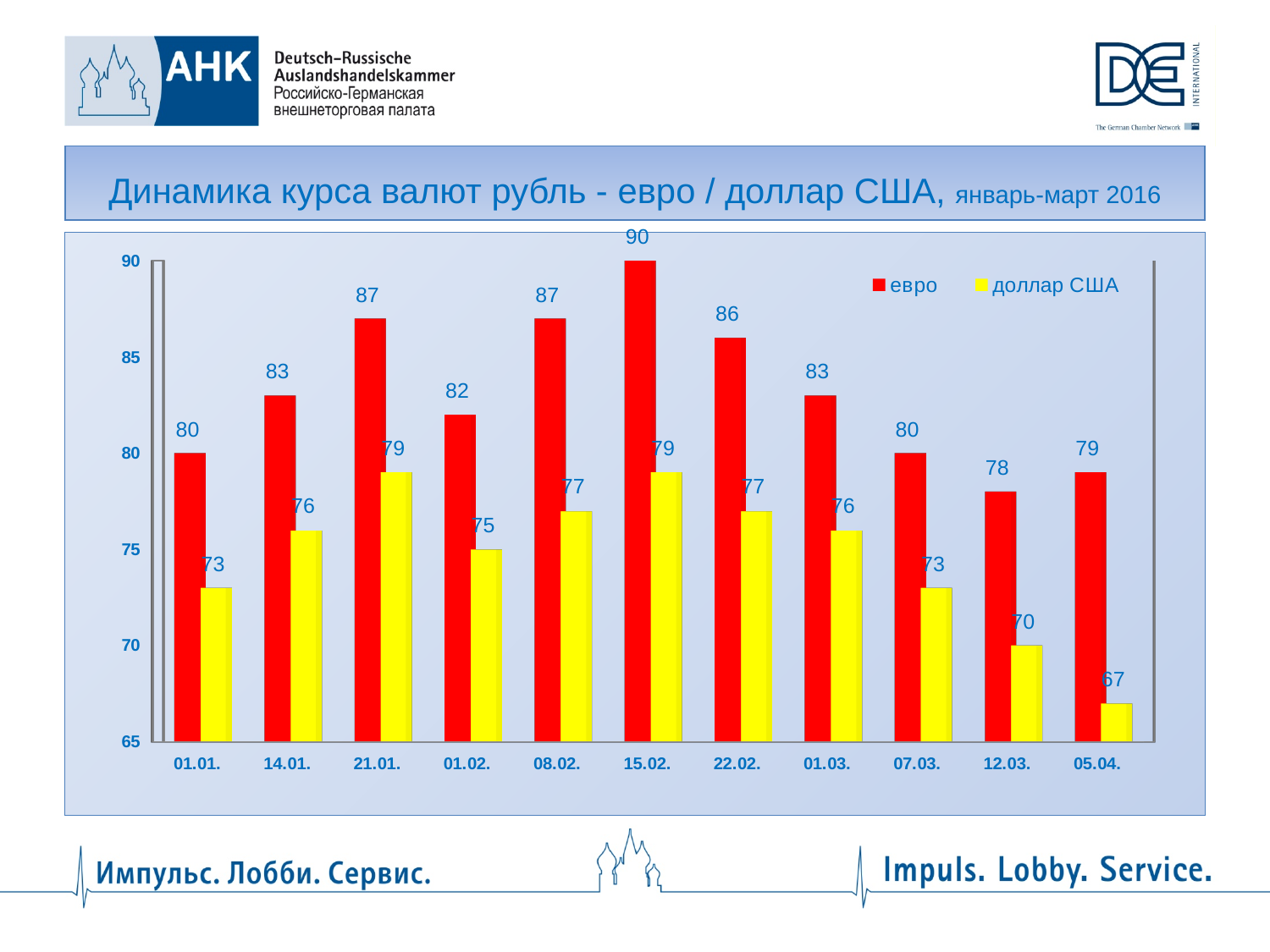
What is the value for доллар США on 21.01.? 79 What is the value for доллар США on 05.04.? 67 What is the difference between the евро and доллар США values on 01.01.? 7 How many dates are shown on the x axis? 11 How many series does the legend list? 2 Is the доллар США value on 12.03. greater or less than 75? less On which date is the евро value highest? 15.02. Which is larger: the евро value on 21.01. or the евро value on 01.02.? 21.01. What is the value for евро on 15.02.? 90 What kind of chart is shown on the slide? bar chart Which colour represents доллар США in the chart? yellow On which date is the доллар США value lowest? 05.04.